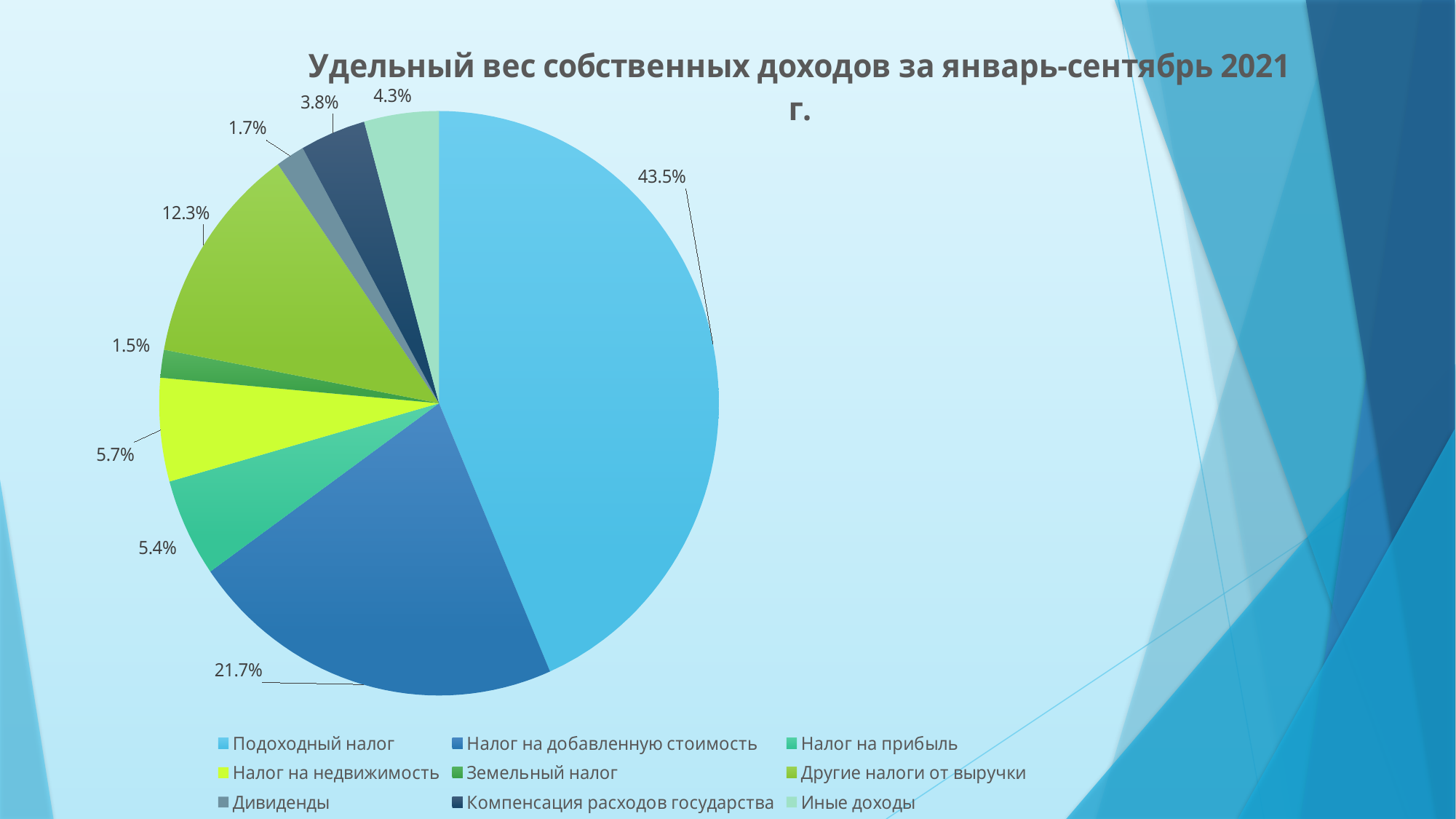
How many categories does the legend list? 9 Which is larger: the share of Налог на недвижимость or the share of Налог на прибыль? Налог на недвижимость Which category has the largest slice of the pie? Подоходный налог What is the share of Компенсация расходов государства? 3.8% What is the difference between the shares of Подоходный налог and Налог на добавленную стоимость? 21.8% What is the share of Земельный налог? 1.5% What is the title of the chart? Удельный вес собственных доходов за январь-сентябрь 2021 г. What is the share of Другие налоги от выручки? 12.3% Which category has the smallest slice of the pie? Земельный налог What type of chart is shown on the slide? pie chart What is the share of Подоходный налог in the pie chart? 43.5% What is the share of Налог на добавленную стоимость? 21.7%